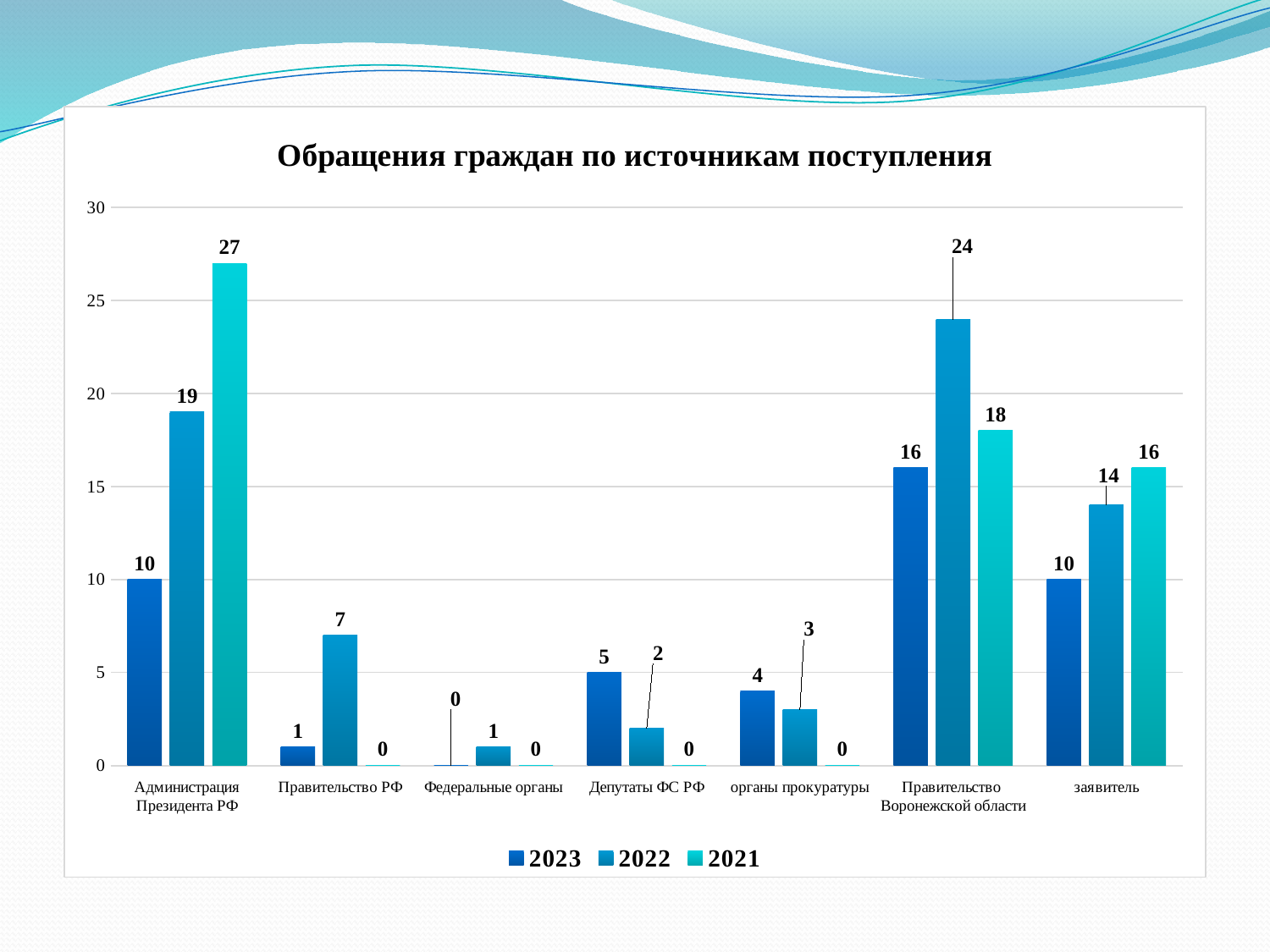
What is the title of the chart? Обращения граждан по источникам поступления What is the difference between the 2022 and 2023 values for Администрация Президента РФ? 9 What is the 2022 value for Правительство Воронежской области? 24 What is the 2023 value for заявитель? 10 What is the 2021 value for Администрация Президента РФ? 27 Which category has the lowest 2022 value? Федеральные органы Which category has the highest 2023 value? Правительство Воронежской области How many categories are shown on the x axis? 7 What type of chart is shown on the slide? bar chart How many series does the legend list? 3 Which is larger for Депутаты ФС РФ: the 2023 value or the 2022 value? 2023 Is the 2021 value for Правительство Воронежской области greater or less than 15? greater